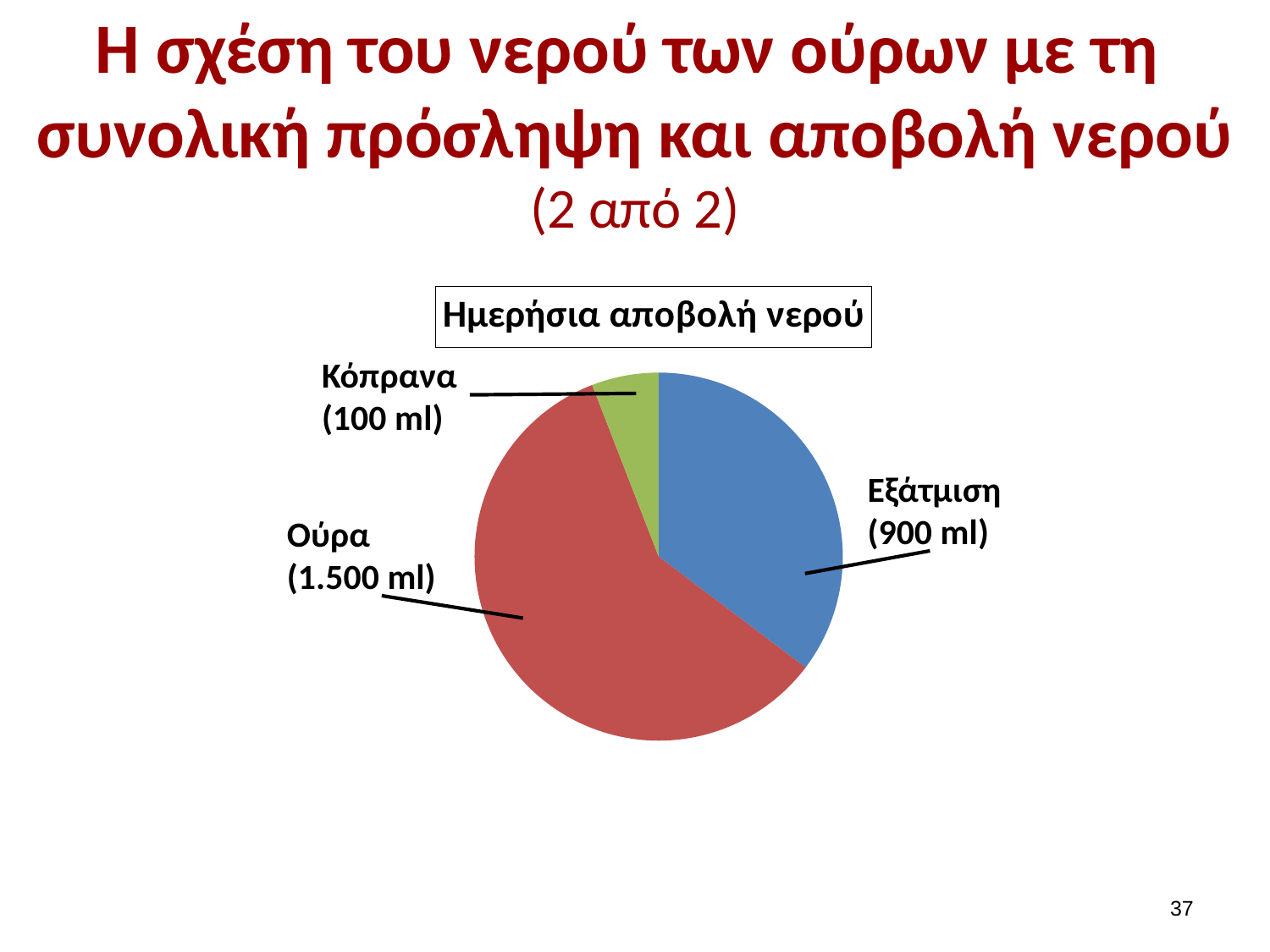
What is the difference between the values for Ούρα and Εξάτμιση? 600 ml What is the title of the chart? Ημερήσια αποβολή νερού What is the value for Ούρα? 1.500 ml Which is larger, the value for Εξάτμιση or the value for Κόπρανα? Εξάτμιση What is the value for Εξάτμιση? 900 ml What is the value for Κόπρανα? 100 ml What is the total of all three slices in the pie chart? 2.500 ml Which category has the largest slice of the pie? Ούρα Which category has the smallest slice of the pie? Κόπρανα How many slices does the pie chart have? 3 What type of chart is shown on the slide? pie chart What share of the pie does Ούρα represent? 60%